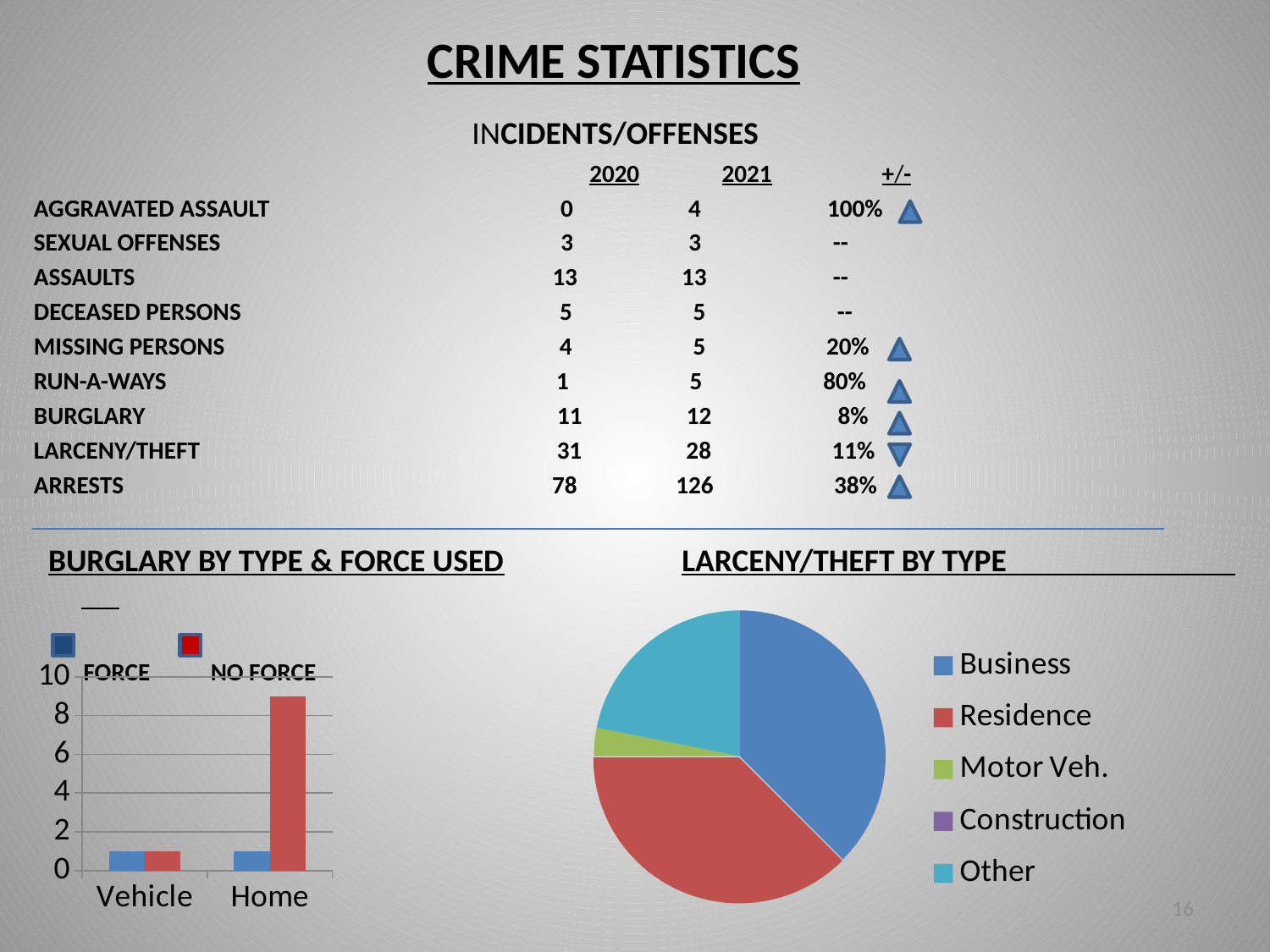
In the BURGLARY BY TYPE & FORCE USED chart, which bar is the tallest? NO FORCE for Home In the BURGLARY BY TYPE & FORCE USED chart, is the FORCE value for Vehicle greater or less than 2? less In the BURGLARY BY TYPE & FORCE USED chart, is the NO FORCE value for Home greater or less than 8? greater In the LARCENY/THEFT BY TYPE chart, what are the legend entries? Business, Residence, Motor Veh., Construction, Other In the BURGLARY BY TYPE & FORCE USED chart, what colour represents the NO FORCE series? red What kind of chart is the LARCENY/THEFT BY TYPE chart? pie chart In the BURGLARY BY TYPE & FORCE USED chart, how many categories are shown on the x axis? 2 In the LARCENY/THEFT BY TYPE chart, how many entries does the legend list? 5 In the BURGLARY BY TYPE & FORCE USED chart, which series has the larger value for Home, FORCE or NO FORCE? NO FORCE In the BURGLARY BY TYPE & FORCE USED chart, how many series does the legend list? 2 What kind of chart is the BURGLARY BY TYPE & FORCE USED chart? bar chart In the LARCENY/THEFT BY TYPE chart, which slice is larger, Other or Motor Veh.? Other